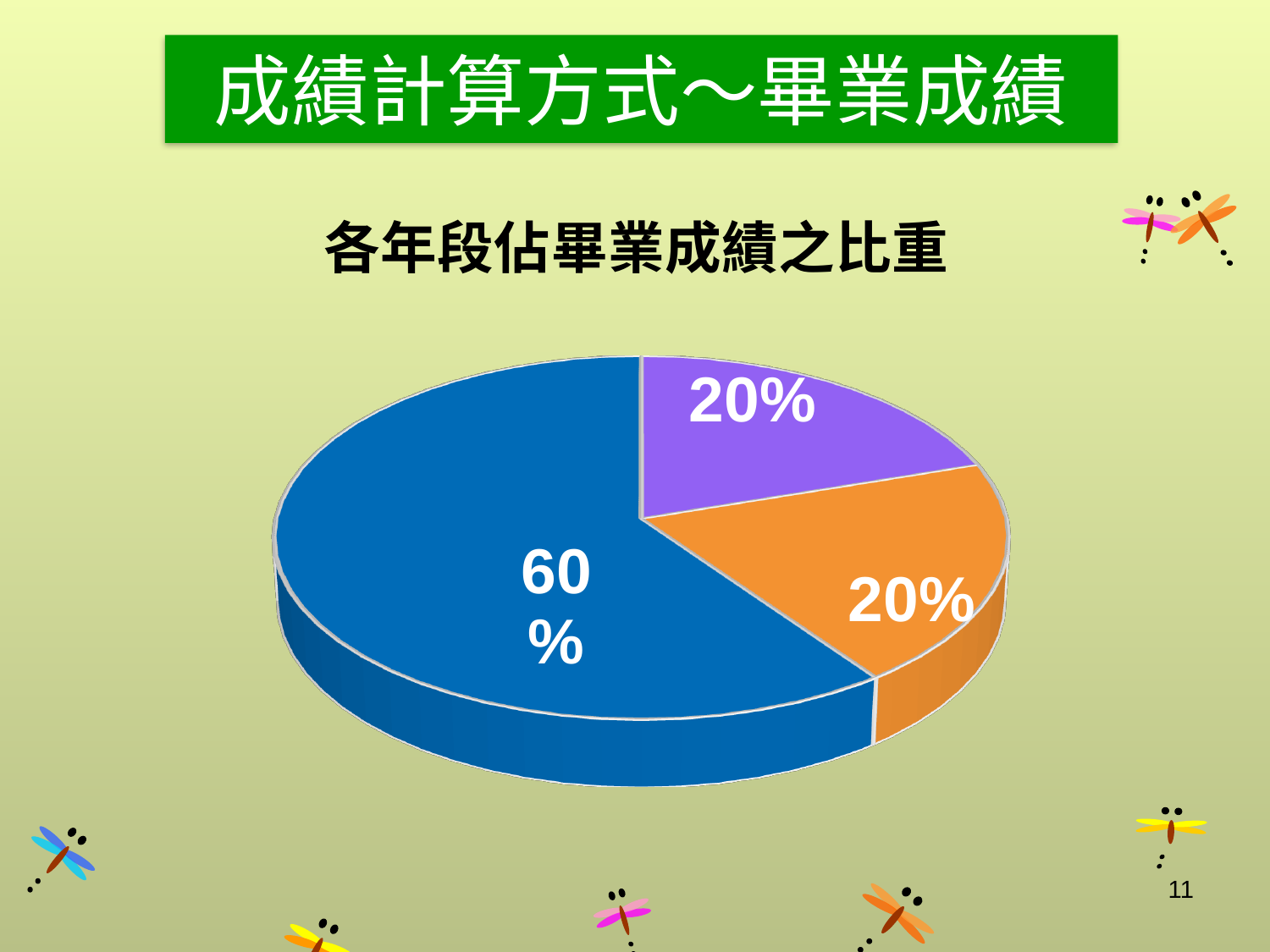
What do the three slice percentages add up to? 100% What percentage is shown on the purple slice of the pie chart? 20% What is the difference in percentage points between the blue slice and the purple slice? 40 What percentage is shown on the blue slice of the pie chart? 60% What percentage is shown on the orange slice of the pie chart? 20% What is the title of the pie chart? 各年段佔畢業成績之比重 Which colour slice is the largest in the pie chart? blue How many slices does the pie chart have? 3 Which is larger, the blue slice or the orange slice? blue slice Is the value of the blue slice greater or less than 50%? greater Does the pie chart display a legend? No What kind of chart is shown on the slide? pie chart